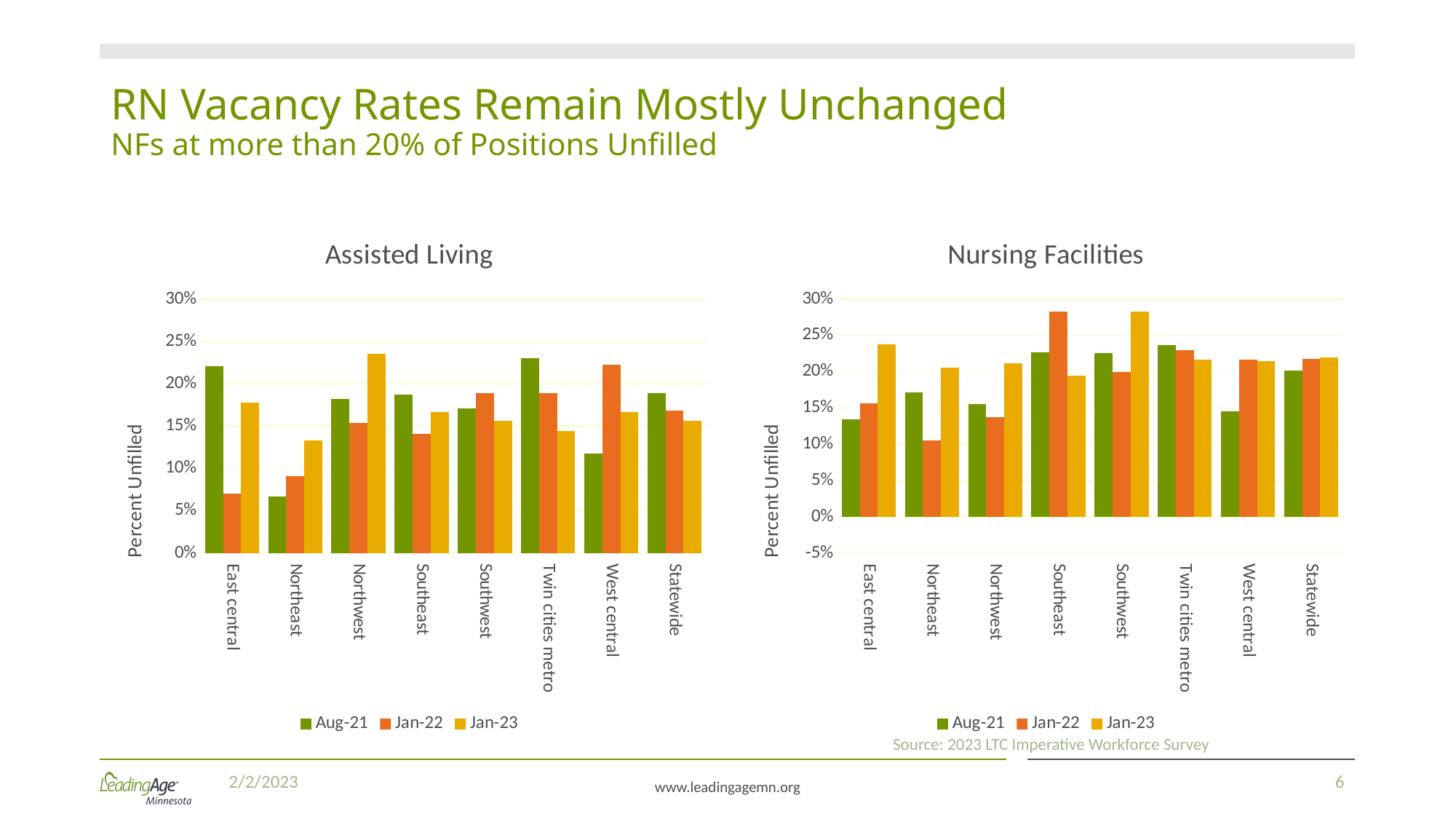
In the Assisted Living chart, which region has the highest Jan-22 value? West central What is the y-axis title of the Nursing Facilities chart? Percent Unfilled In the Assisted Living chart, which region has the lowest Aug-21 value? Northeast In the Nursing Facilities chart, which region has the lowest Jan-22 value? Northeast In the Assisted Living chart, is the Jan-23 value for Northwest greater or less than 20%? greater In the Assisted Living chart, is the Jan-22 value for East central greater or less than 10%? less How many regional categories are shown on the x axis of the Assisted Living chart? 8 In the Nursing Facilities chart, for Northeast, which is larger: the Aug-21 value or the Jan-22 value? Aug-21 What kind of chart is the Assisted Living chart? bar chart In the Nursing Facilities chart, is the Jan-23 value for East central greater or less than 20%? greater How many series does the legend of the Nursing Facilities chart list? 3